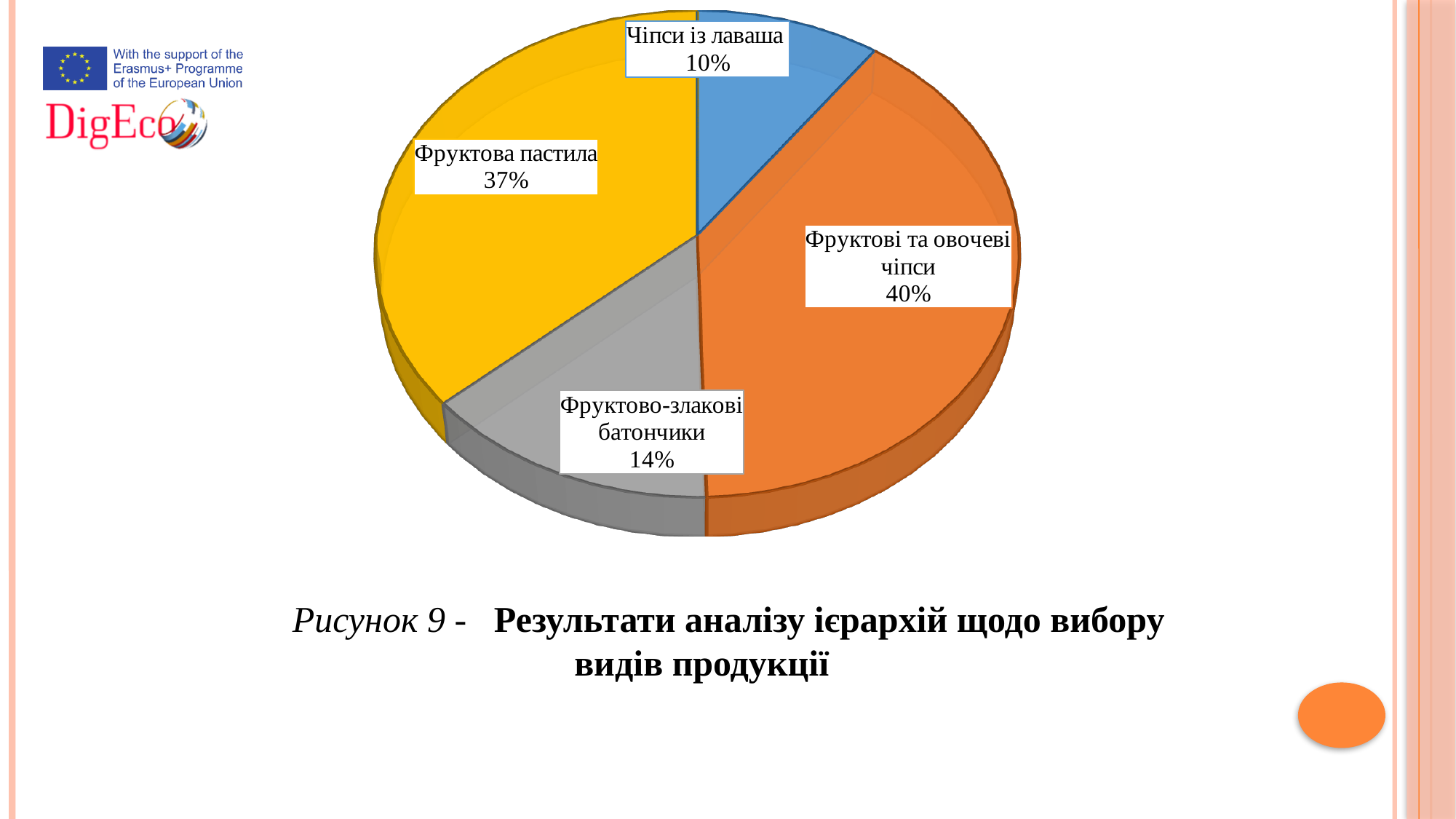
What kind of chart is shown on the slide? Pie chart What is the difference in percentage points between Фруктові та овочеві чіпси and Фруктова пастила? 3% What is the difference in percentage points between Фруктово-злакові батончики and Чіпси із лаваша? 4% Which is larger: the share for Фруктово-злакові батончики or the share for Чіпси із лаваша? Фруктово-злакові батончики Which category has the largest share of the pie? Фруктові та овочеві чіпси Which category has the smallest share of the pie? Чіпси із лаваша What share of the pie does Фруктова пастила have? 37% What share of the pie does Фруктові та овочеві чіпси have? 40% How many categories are shown in the pie chart? 4 What colour is the slice for Фруктова пастила? Yellow What share of the pie does Фруктово-злакові батончики have? 14% What share of the pie does Чіпси із лаваша have? 10%